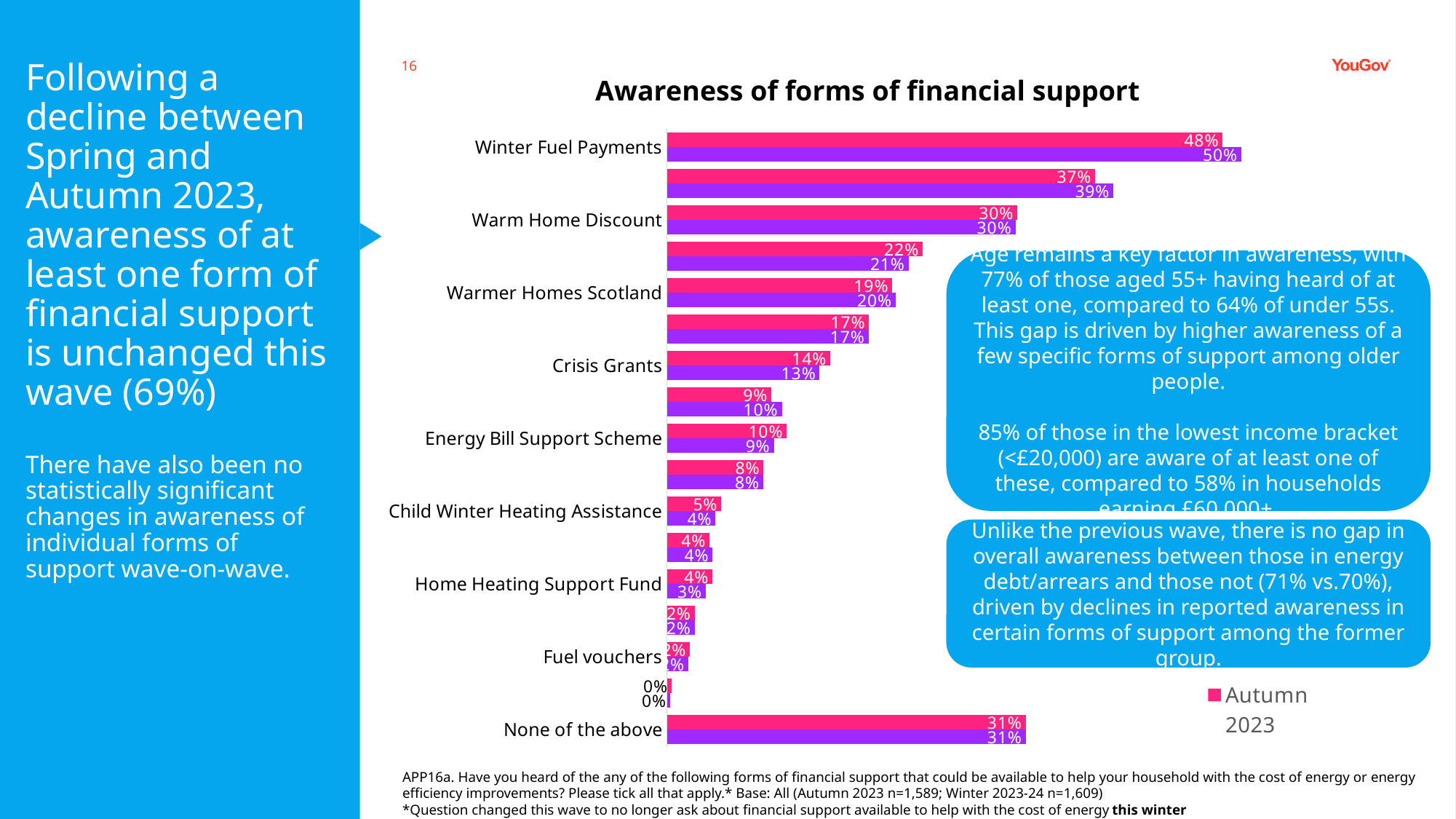
What is the Autumn 2023 value for None of the above? 31% What colour represents Autumn 2023 in the chart legend? Pink What is the Autumn 2023 value for Child Winter Heating Assistance? 5% What type of chart is shown on the slide? Bar chart What is the Autumn 2023 value for Winter Fuel Payments? 48% What is the Autumn 2023 value for Warm Home Discount? 30% What is the title of the chart? Awareness of forms of financial support What is the Autumn 2023 value for Crisis Grants? 14% Which form of financial support has the highest Autumn 2023 awareness? Winter Fuel Payments Which has a larger Autumn 2023 value, Warmer Homes Scotland or Home Heating Support Fund? Warmer Homes Scotland What is the difference between the Autumn 2023 values for Winter Fuel Payments and Warm Home Discount? 18 percentage points Which has a larger Autumn 2023 value, Crisis Grants or Energy Bill Support Scheme? Crisis Grants